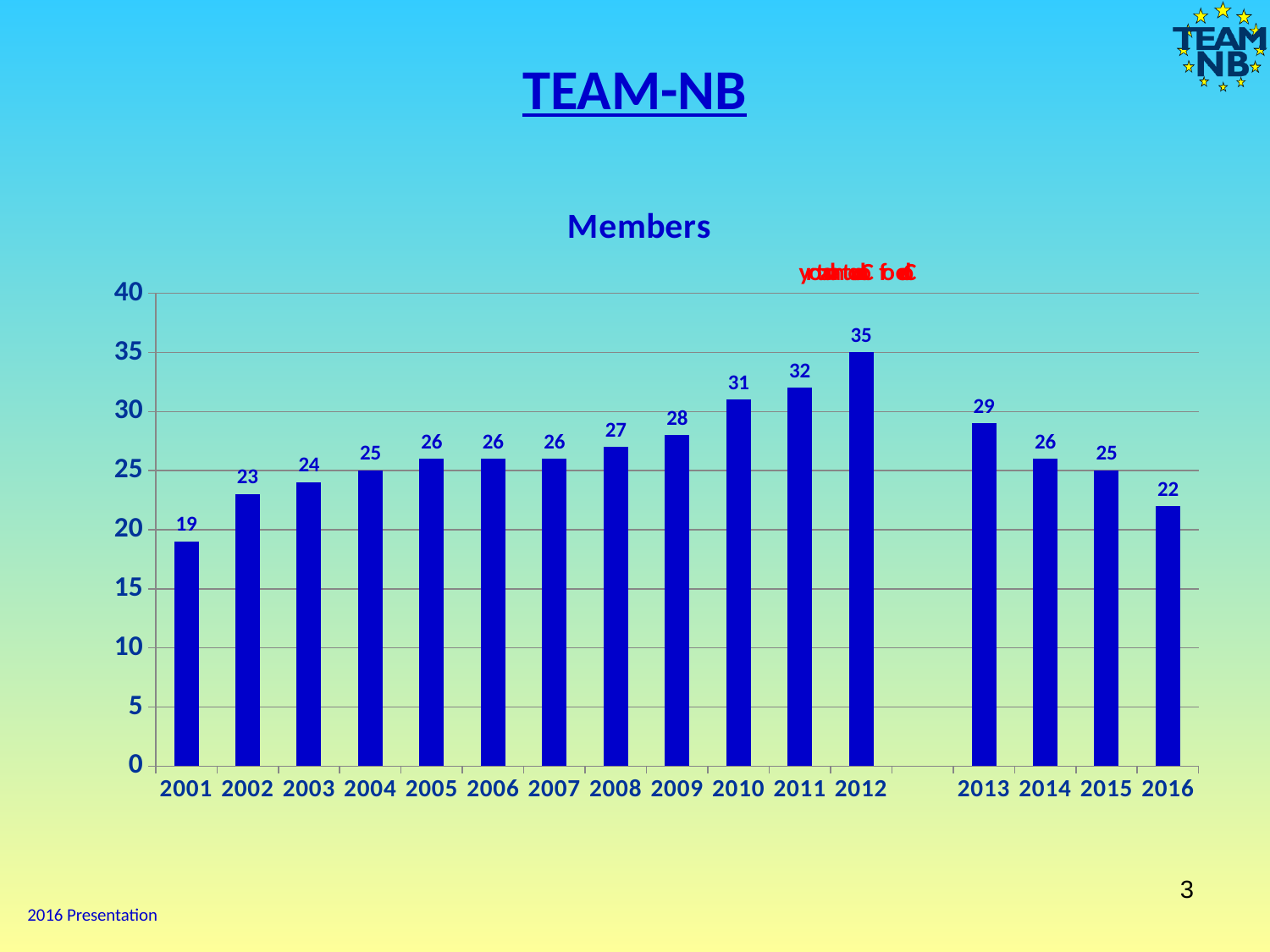
How many years are shown on the x axis of the Members chart? 16 Is the value for 2011 in the Members chart greater or less than 30? greater What is the value for 2016 in the Members chart? 22 Which year has the lowest value in the Members chart? 2001 What is the value for 2012 in the Members chart? 35 Which year has the highest value in the Members chart? 2012 What is the title of the chart on the slide? Members Do the values in the Members chart rise or fall from 2001 to 2012? rise What kind of chart is the Members chart? bar chart What is the difference between the values for 2012 and 2013 in the Members chart? 6 What is the value for 2001 in the Members chart? 19 Which is larger in the Members chart, the value for 2010 or the value for 2013? 2010